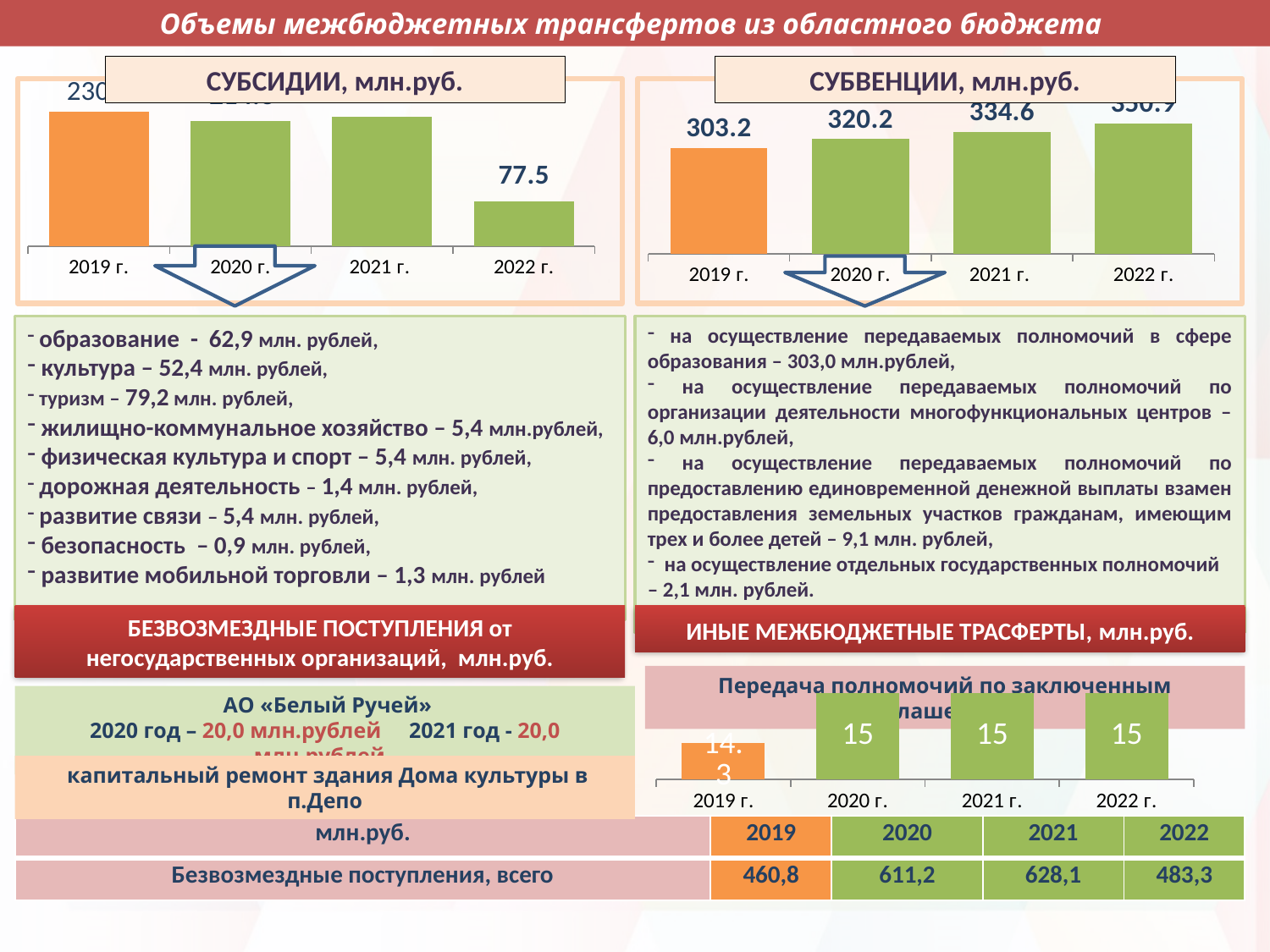
What kind of chart is the СУБСИДИИ, млн.руб. chart? bar chart On the СУБВЕНЦИИ, млн.руб. chart, what is the value for 2019 г.? 303.2 On the СУБВЕНЦИИ, млн.руб. chart, do the values rise or fall from 2019 г. to 2022 г.? rise On the СУБСИДИИ, млн.руб. chart, how many years are shown? 4 On the СУБВЕНЦИИ, млн.руб. chart, which year has the lowest value? 2019 г. On the СУБСИДИИ, млн.руб. chart, which year has the lowest value? 2022 г. On the СУБСИДИИ, млн.руб. chart, what is the value for 2022 г.? 77.5 On the bottom-right chart under ИНЫЕ МЕЖБЮДЖЕТНЫЕ ТРАСФЕРТЫ, what is the value for 2020 г.? 15 On the bottom-right chart under ИНЫЕ МЕЖБЮДЖЕТНЫЕ ТРАСФЕРТЫ, which year has the lowest value? 2019 г. On the СУБВЕНЦИИ, млн.руб. chart, what is the value for 2021 г.? 334.6 On the СУБВЕНЦИИ, млн.руб. chart, what is the difference between the 2020 г. and 2019 г. values? 17.0 On the СУБВЕНЦИИ, млн.руб. chart, which is larger, the value for 2021 г. or 2020 г.? 2021 г.